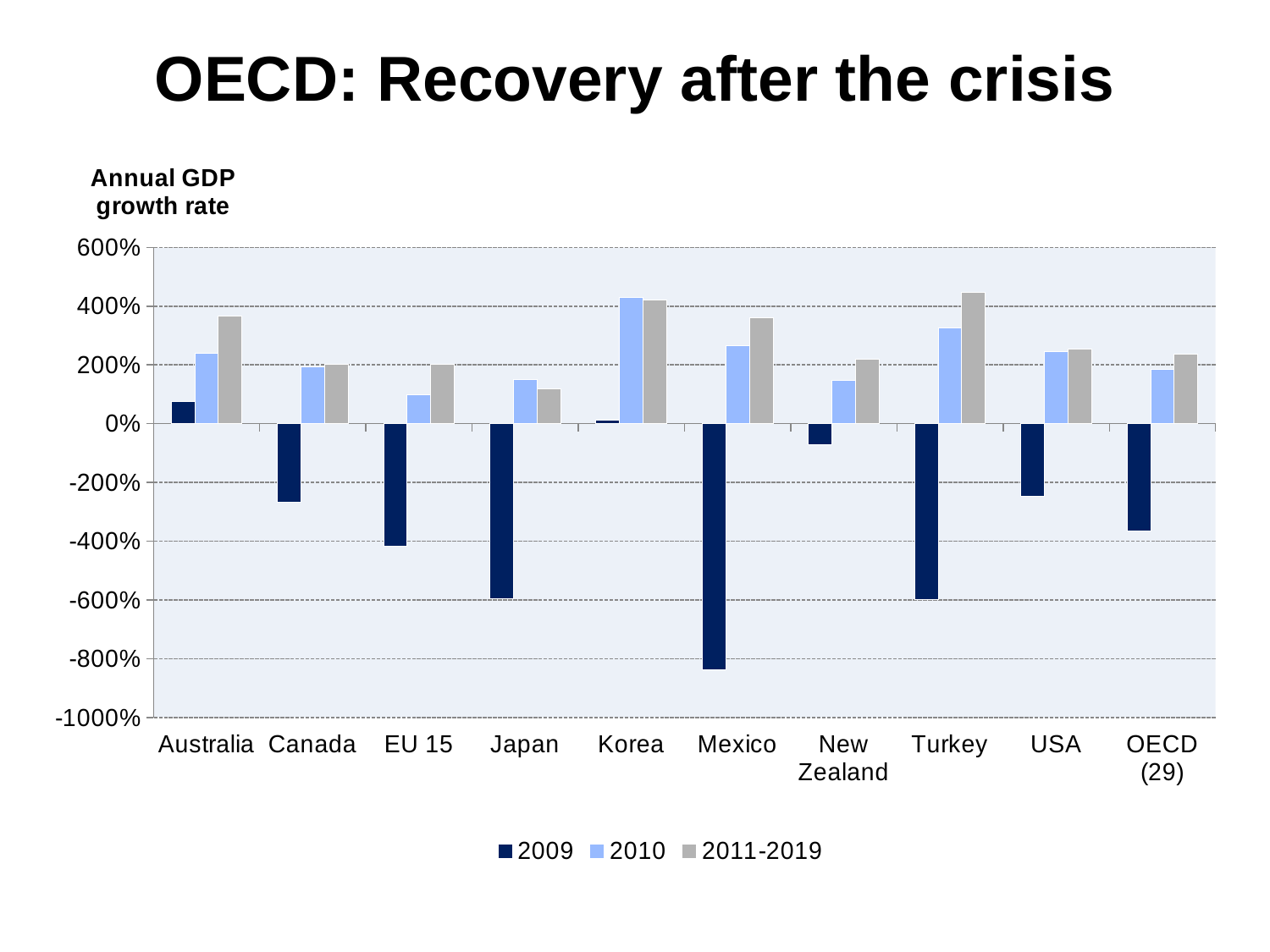
How many series does the legend list? 3 Is the 2009 value for Japan greater or less than -400%? less Which category has the lowest value for the 2009 series? Mexico For the 2010 series, which is larger: Australia or EU 15? Australia Is the 2011-2019 value for Turkey greater or less than 400%? greater How many categories are shown along the x axis? 10 Is the 2009 value for Mexico greater or less than -600%? less What label is shown on the vertical axis of the chart? Annual GDP growth rate What type of chart is shown on the slide? bar chart Which category has the highest value for the 2009 series? Australia Which category has the highest value for the 2010 series? Korea